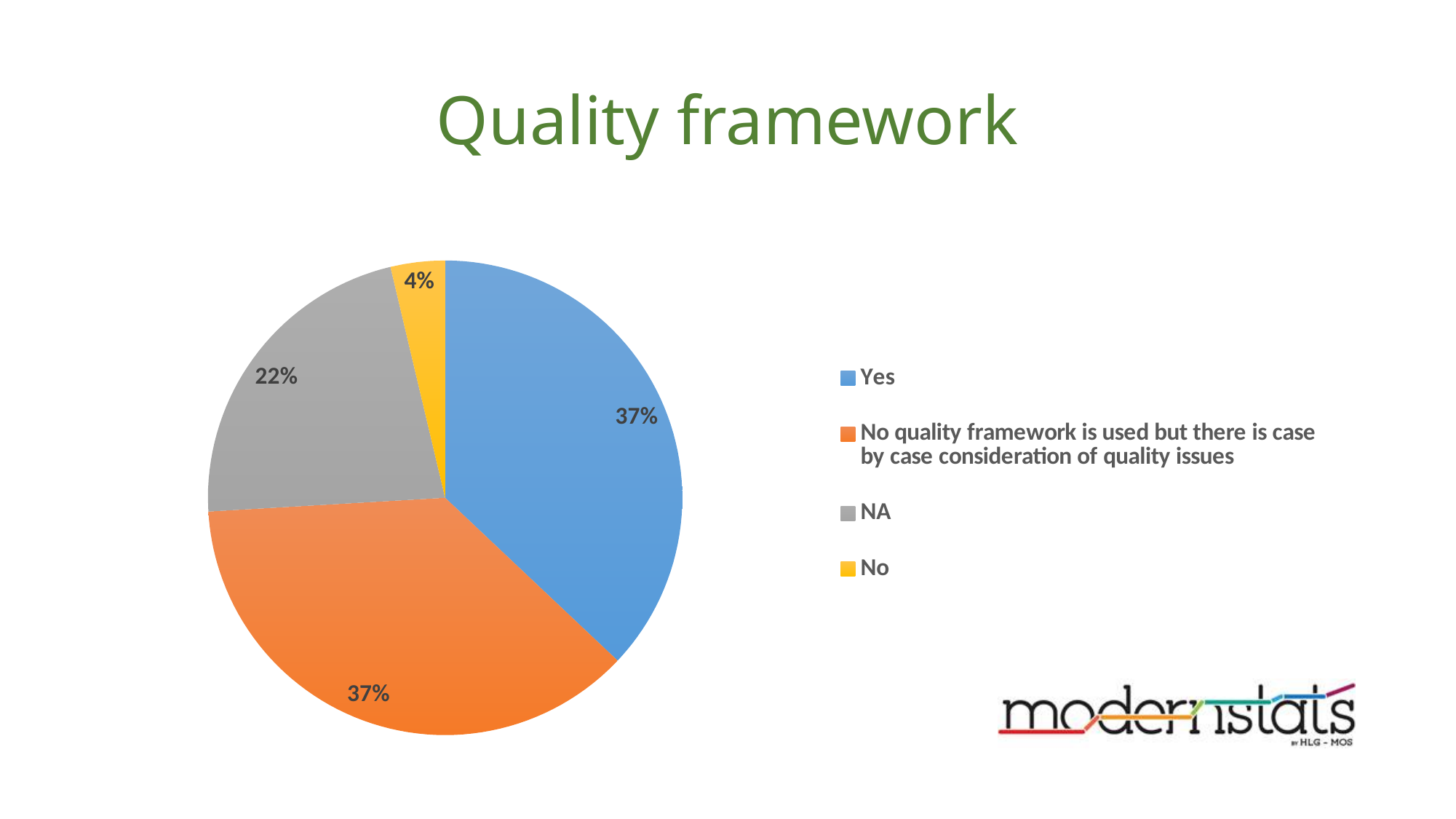
What share of the pie does the "NA" slice represent? 22% Which is larger, the "NA" slice or the "No" slice? NA What share of the pie does the "No quality framework is used but there is case by case consideration of quality issues" slice represent? 37% What is the difference between the "NA" share and the "No" share? 18% How many slices does the pie chart have? 4 What share of the pie does the "No" slice represent? 4% What kind of chart is shown on the slide? pie chart What is the title of the slide containing the pie chart? Quality framework What is the difference between the "Yes" share and the "NA" share? 15% Which category has the smallest slice of the pie? No What colour is the "NA" slice in the pie chart? grey